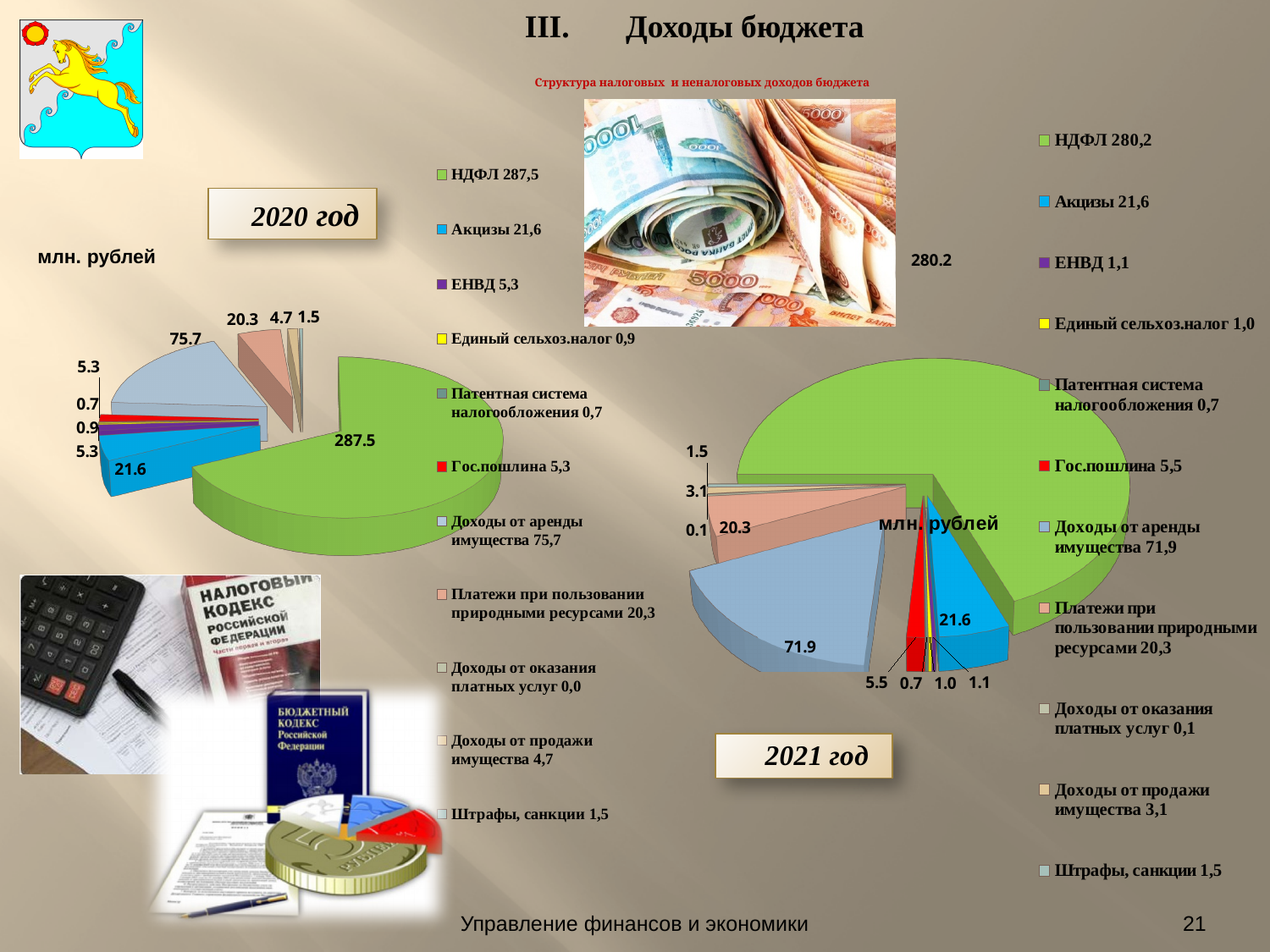
On the 2021 год chart, what is the value for Доходы от аренды имущества? 71.9 On the 2021 год chart, which is larger: Платежи при пользовании природными ресурсами or Акцизы? Акцизы On the 2020 год chart, which category has the largest slice? НДФЛ On the 2021 год chart, which category has the largest slice? НДФЛ On the 2021 год chart, what is the value for Доходы от продажи имущества? 3.1 On the 2020 год chart, what is the value for НДФЛ? 287.5 On the 2021 год chart, what is the difference between Акцизы and Гос.пошлина? 16.1 On the 2020 год chart, what is the difference between НДФЛ and Доходы от аренды имущества? 211.8 What type of chart is used for the 2020 год data? Pie chart On the 2020 год chart, which is larger: Доходы от продажи имущества or Штрафы, санкции? Доходы от продажи имущества What unit is stated for the values on the charts? млн. рублей How many categories does the legend of the 2021 год chart list? 11